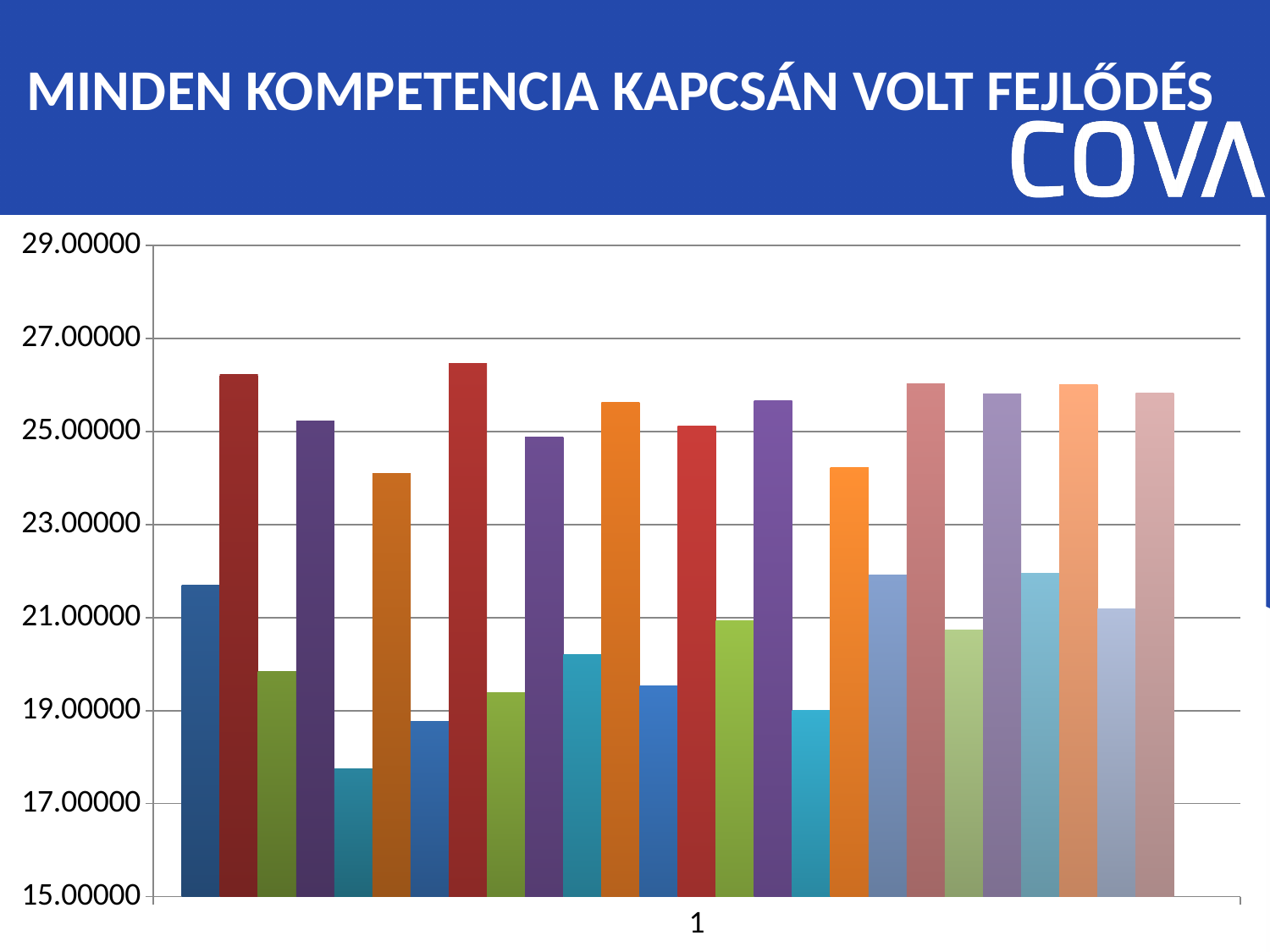
Is the value of the third bar from the left in the chart greater or less than 21? less Is the value of the rightmost bar in the chart greater or less than 25? greater Is the value of the second bar from the left in the chart greater or less than 25? greater What is the label of the single category on the x axis? 1 What kind of chart is shown on the slide? bar chart How many categories are shown on the x axis of the chart? 1 What is the highest value shown on the y axis of the chart? 29.00000